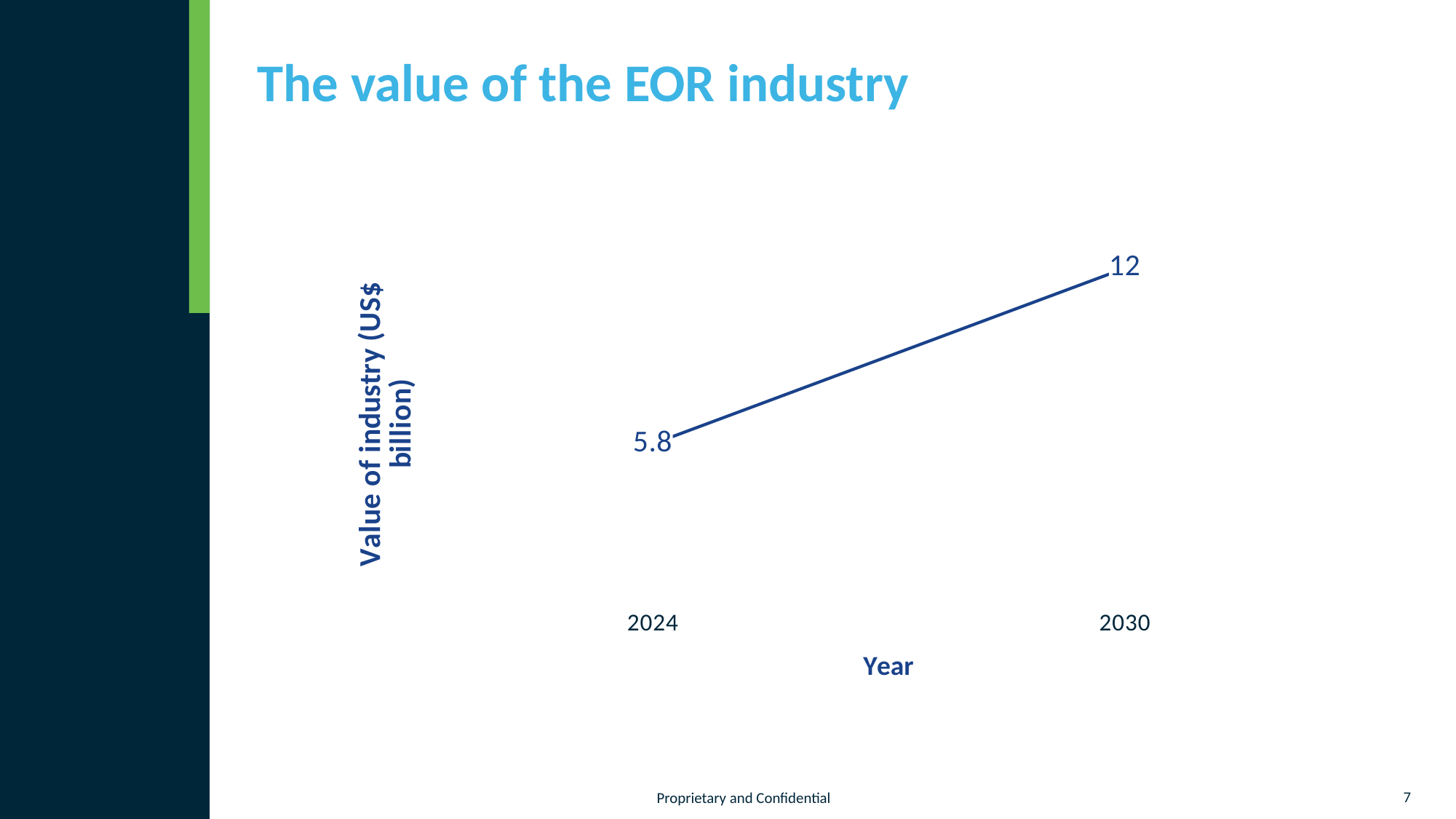
What is the difference between the 2030 value and the 2024 value? 6.2 Which year has the higher value of industry? 2030 What kind of chart is shown on the slide? line chart Is the value for 2030 larger or smaller than the value for 2024? larger Which year has the lower value of industry? 2024 What is the value of the EOR industry in 2030? 12 What is the label of the y axis? Value of industry (US$ billion) What is the label of the x axis? Year What is the value of the EOR industry in 2024? 5.8 Does the value of the industry rise or fall from 2024 to 2030? rise How many data points are plotted on the chart? 2